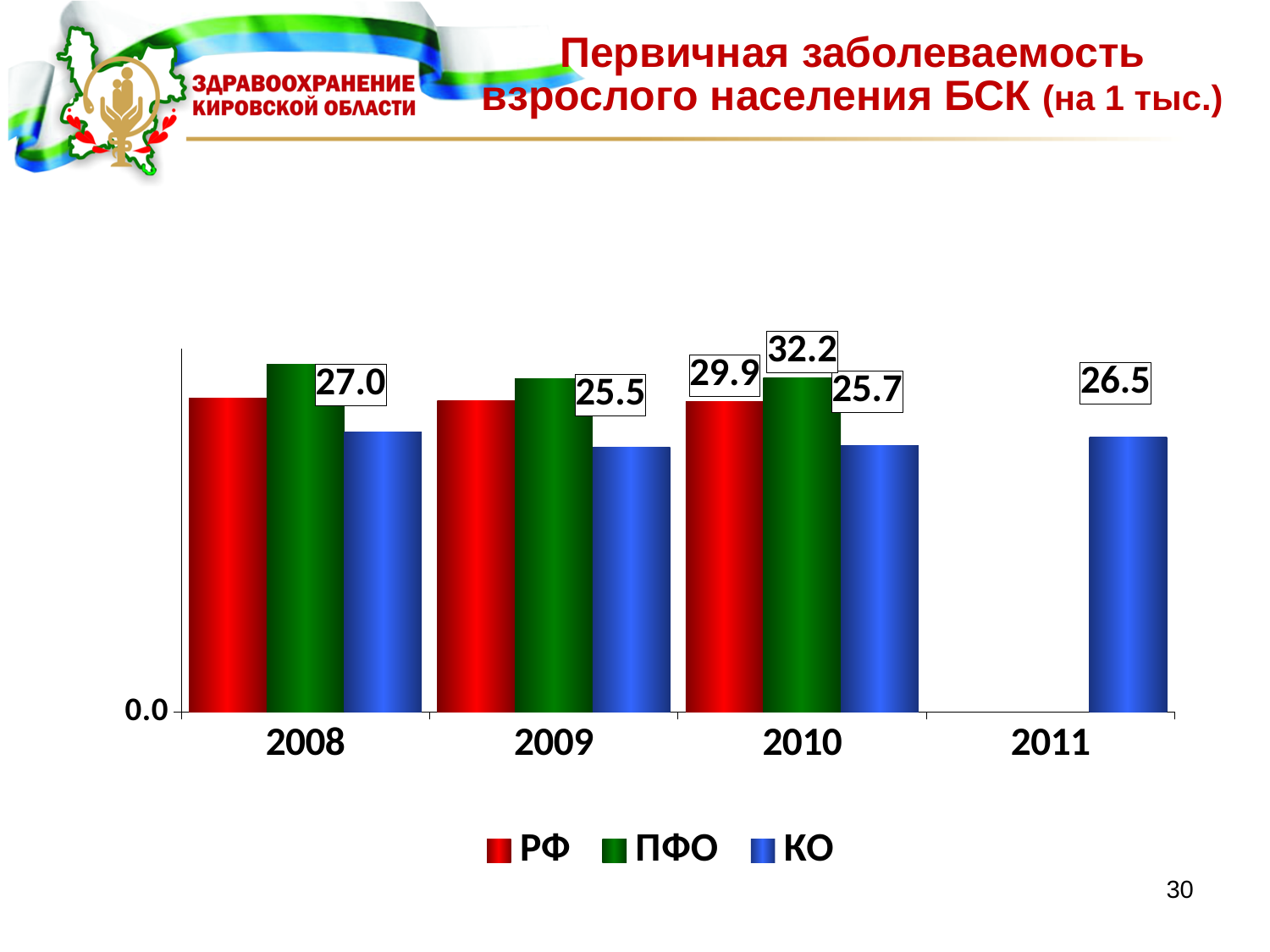
What is the difference between the ПФО and РФ values in 2010? 2.3 What is the value for КО in 2008? 27.0 What is the value for КО in 2009? 25.5 Which is larger in 2010, the value for РФ or the value for КО? РФ Which series has the highest value in 2010? ПФО What kind of chart is shown on the slide? Bar chart What is the value for РФ in 2010? 29.9 How many years are shown on the x axis? 4 How many series does the legend list? 3 What is the value for ПФО in 2010? 32.2 In which year is the КО value the highest? 2008 What is the value for КО in 2011? 26.5